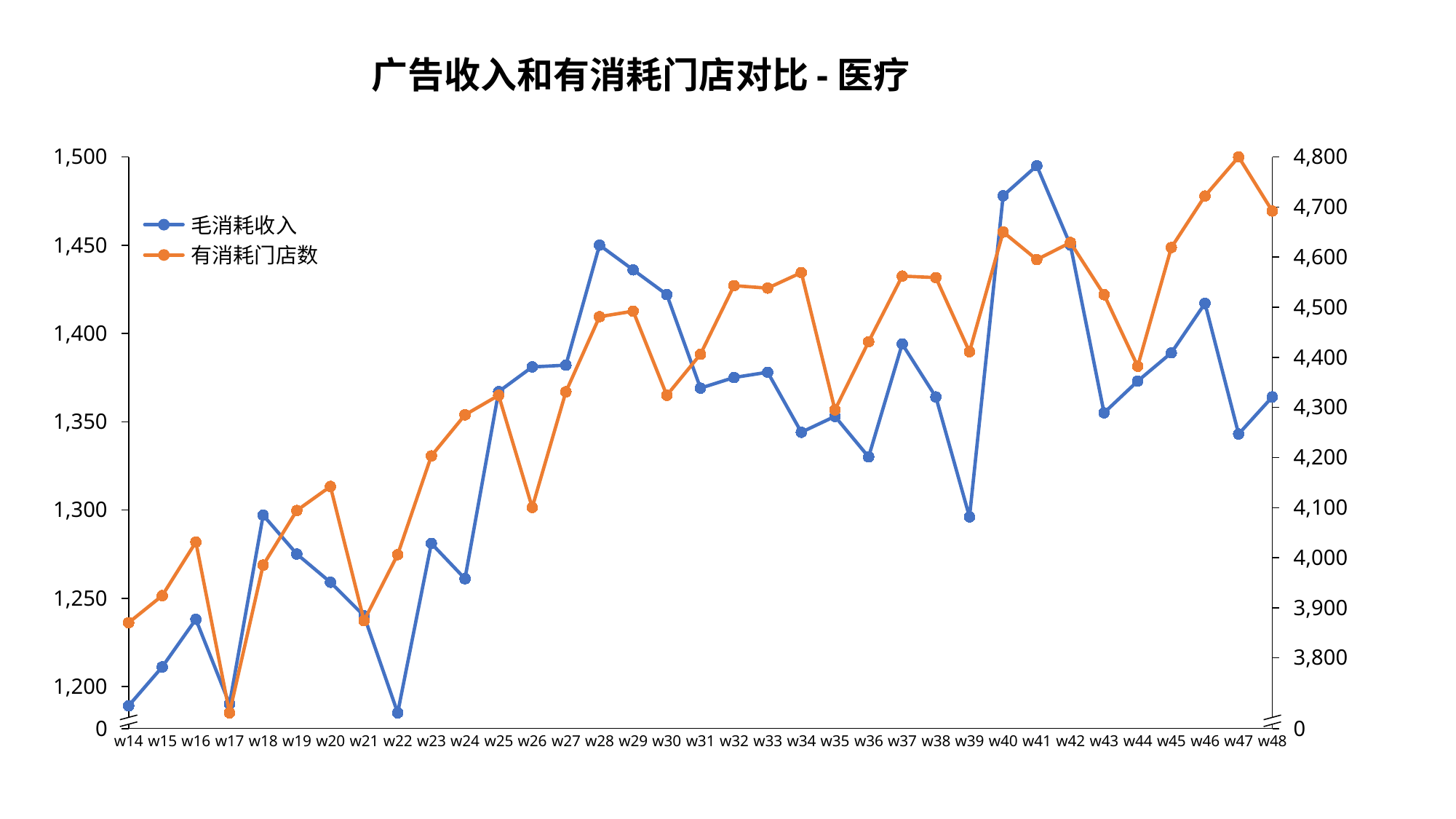
In which week does 毛消耗收入 reach its highest value? w41 What kind of chart is shown on the slide? line chart In which week is 有消耗门店数 at its lowest? w17 Overall, does 有消耗门店数 rise or fall from w14 to w48? rise Is the value of 毛消耗收入 for w28 greater or less than 1,400? greater Which series is drawn in orange? 有消耗门店数 Which week has the larger 毛消耗收入 value, w39 or w41? w41 Is the value of 有消耗门店数 for w40 greater or less than 4,600? greater How many series does the legend list? 2 How many weeks are plotted along the x axis? 35 What is the title of the chart? 广告收入和有消耗门店对比 - 医疗 Is the value of 有消耗门店数 for w26 greater or less than 4,200? less